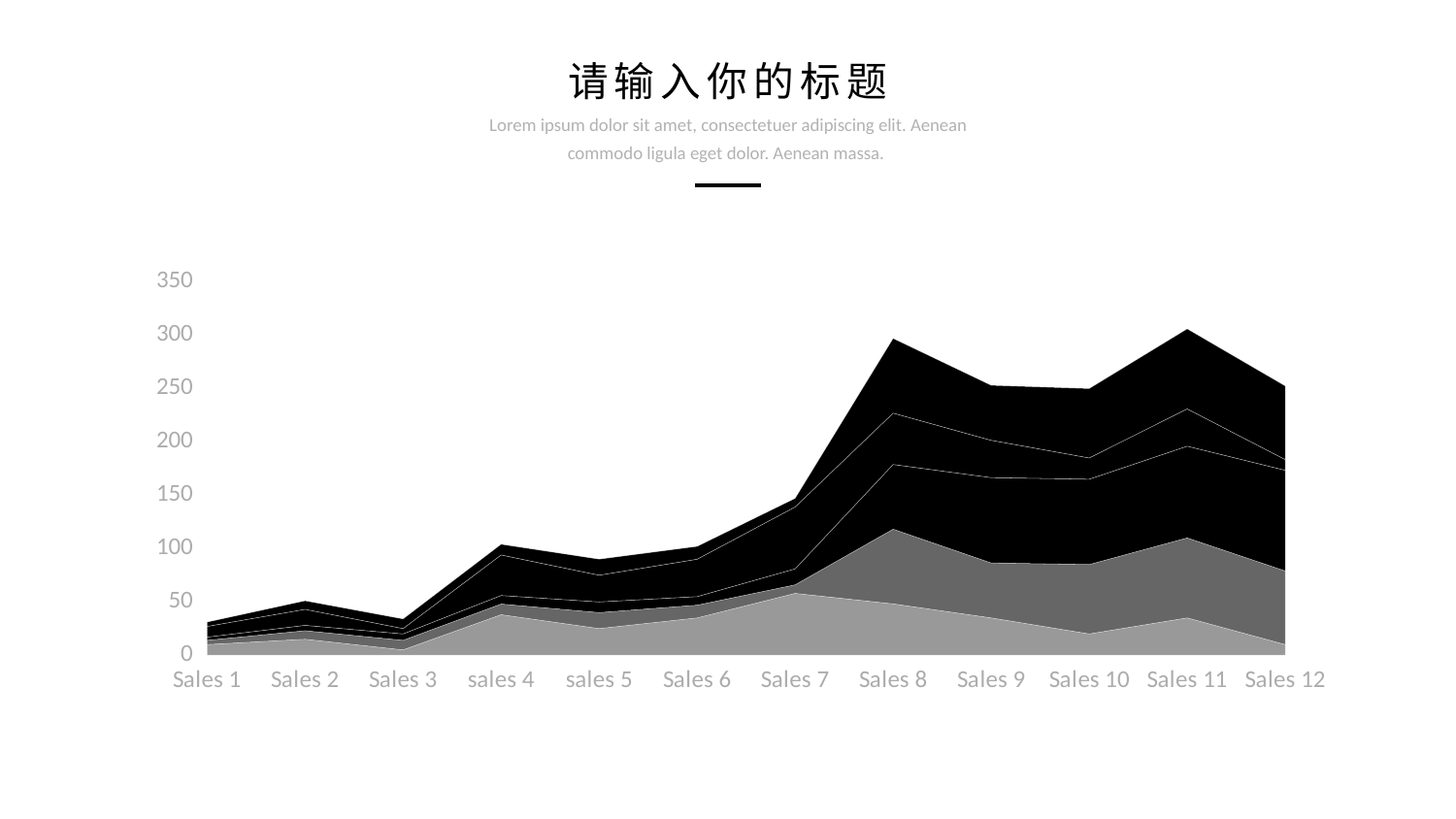
Do the total stacked values generally rise or fall from Sales 1 to Sales 8? rise Is the total stacked value at Sales 12 greater or less than 300? less How many categories are shown along the x axis? 12 Is the total stacked value at Sales 2 greater or less than 100? less Is the total stacked value at Sales 1 greater or less than 50? less What is the highest value shown on the y axis? 350 What kind of chart is shown on the slide? Stacked area chart Which has a larger total stacked value, Sales 7 or Sales 8? Sales 8 Which has a larger total stacked value, Sales 3 or Sales 4? sales 4